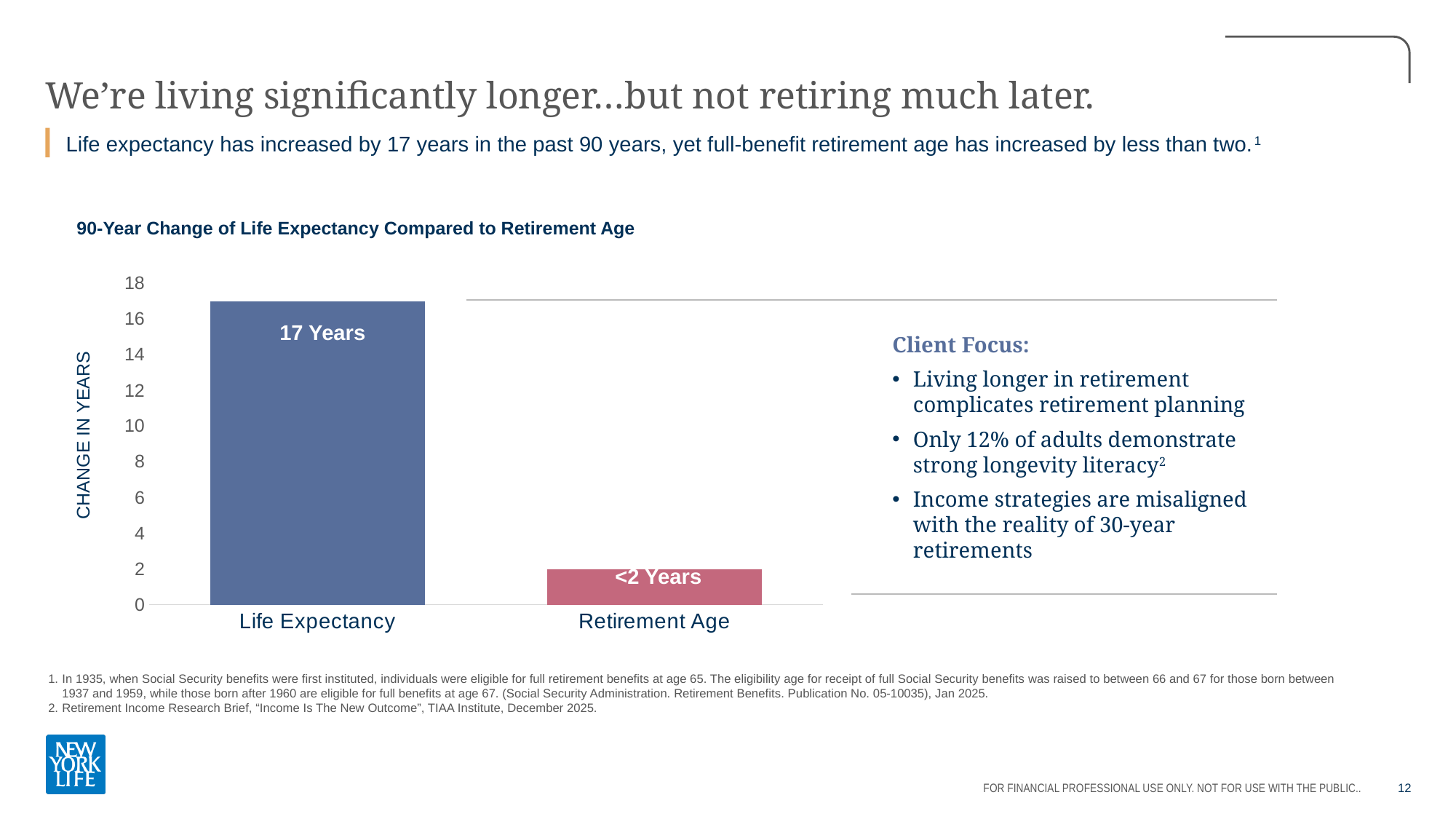
Is the value for Retirement Age greater or less than 4? less How many categories are shown on the x axis? 2 What is the title of the chart? 90-Year Change of Life Expectancy Compared to Retirement Age Which is larger, the value for Life Expectancy or the value for Retirement Age? Life Expectancy Is the value for Life Expectancy greater or less than 10? greater Which category has the lowest value? Retirement Age Which category has the highest value? Life Expectancy What is the label on the vertical axis of the chart? CHANGE IN YEARS What kind of chart is shown on the slide? Bar chart Do the values rise or fall from left to right along the x axis? Fall What is the data label on the Life Expectancy bar? 17 Years What is the data label on the Retirement Age bar? <2 Years